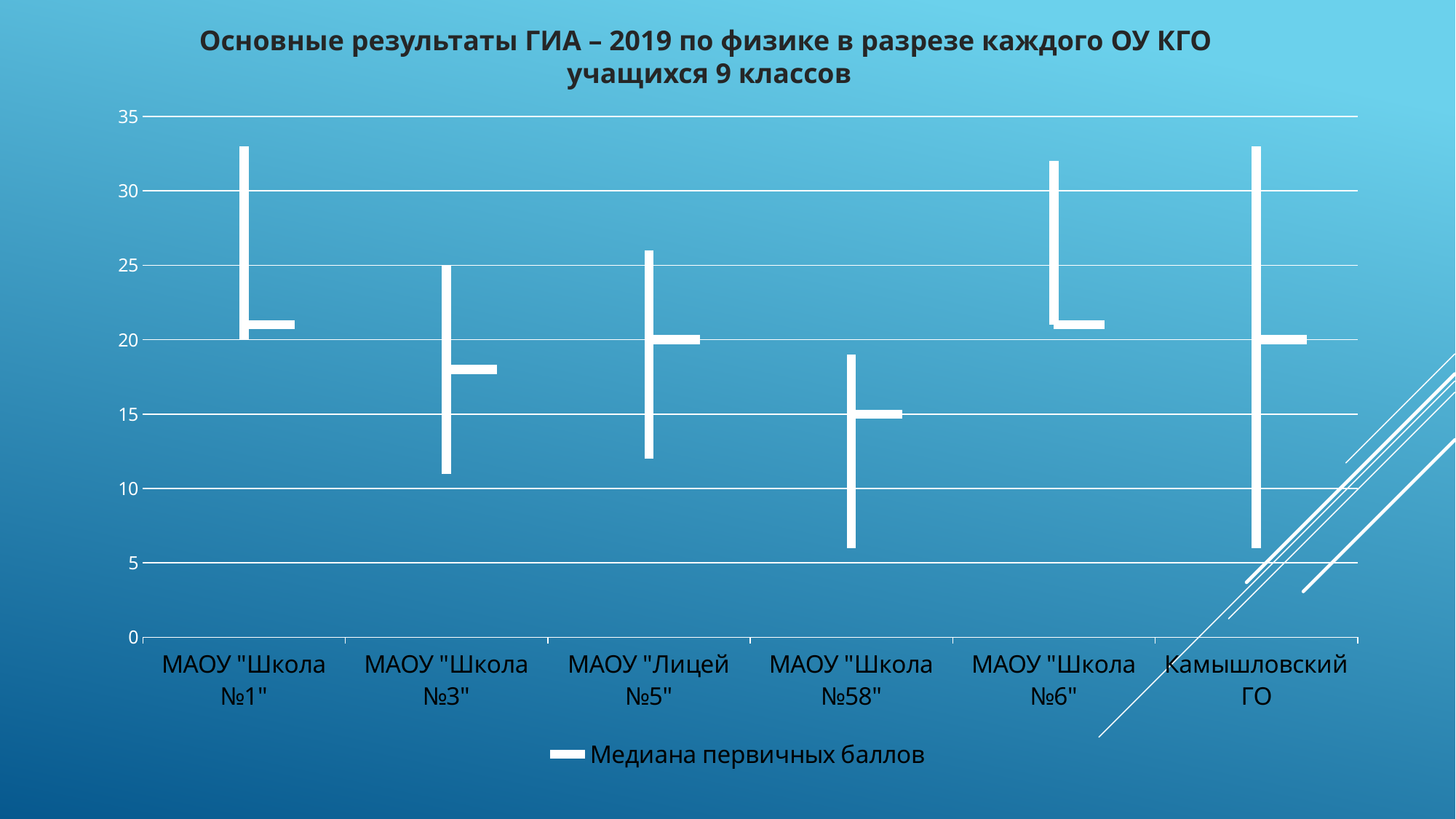
Is the median value for МАОУ "Школа №58" greater or less than 20? less Is the median value for МАОУ "Школа №3" greater or less than 20? less What is the legend entry of the chart? Медиана первичных баллов Which school has the lowest median value? МАОУ "Школа №58" What is the title of the chart? Основные результаты ГИА – 2019 по физике в разрезе каждого ОУ КГО учащихся 9 классов How many series does the legend list? 1 Is the bottom of the range for Камышловский ГО greater or less than 10? less What kind of chart is shown on the slide? stock (high-low-close) chart How many schools (categories) are shown on the x axis? 6 Which has the higher median value, МАОУ "Школа №3" or МАОУ "Лицей №5"? МАОУ "Лицей №5"